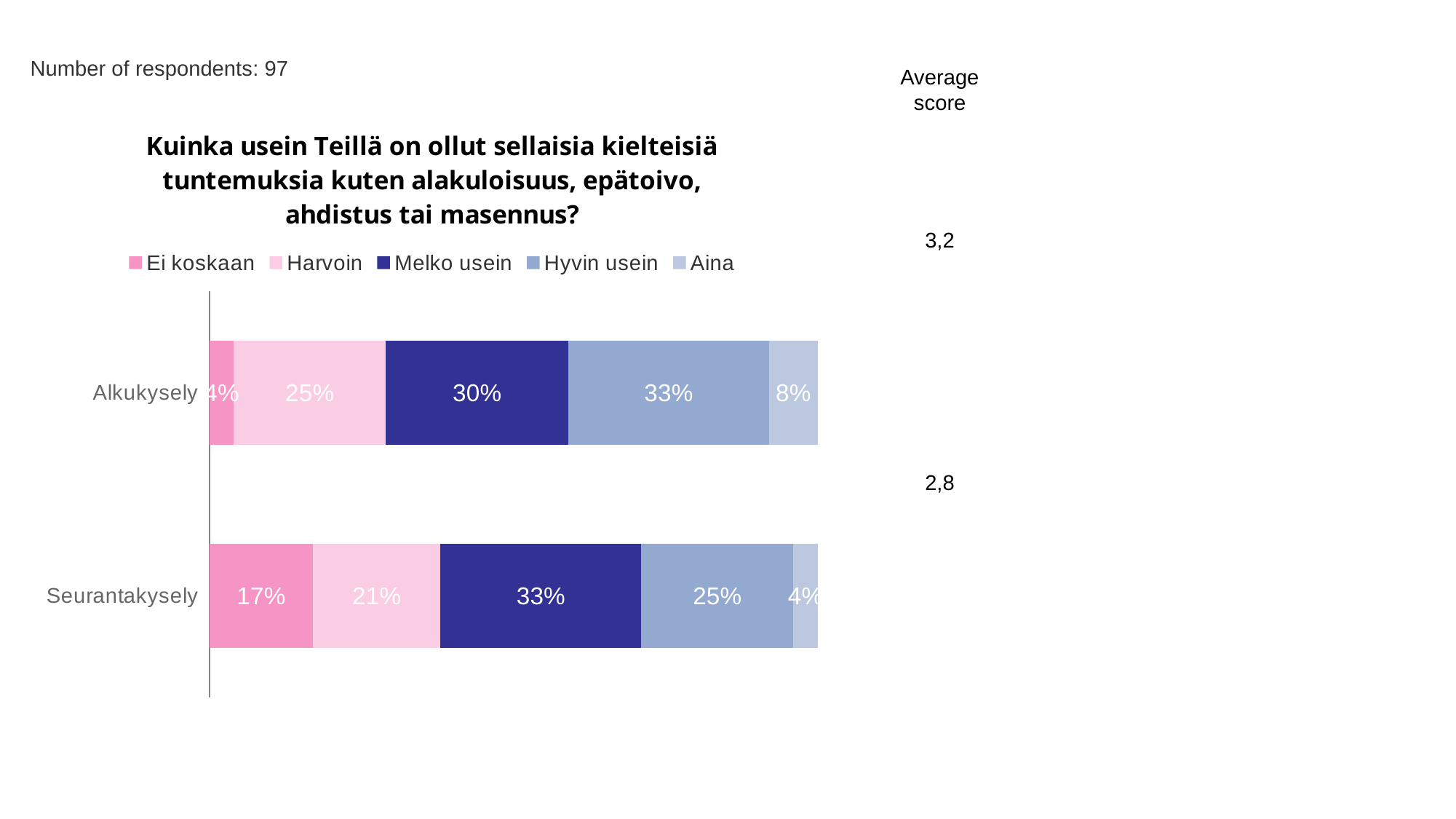
How many categories are plotted on the chart? 2 What is the value for Melko usein in the Alkukysely bar? 30% Which series has the largest share in the Seurantakysely bar? Melko usein What is the difference between the Ei koskaan values for Seurantakysely and Alkukysely? 13% Which is larger: Harvoin for Alkukysely or Harvoin for Seurantakysely? Alkukysely What is the value for Aina in the Seurantakysely bar? 4% What is the average score shown for Seurantakysely? 2,8 What is the value for Hyvin usein in the Alkukysely bar? 33% What kind of chart is shown on the slide? Stacked bar chart How many series does the legend list? 5 Which series has the smallest share in the Alkukysely bar? Ei koskaan What is the value for Ei koskaan in the Seurantakysely bar? 17%